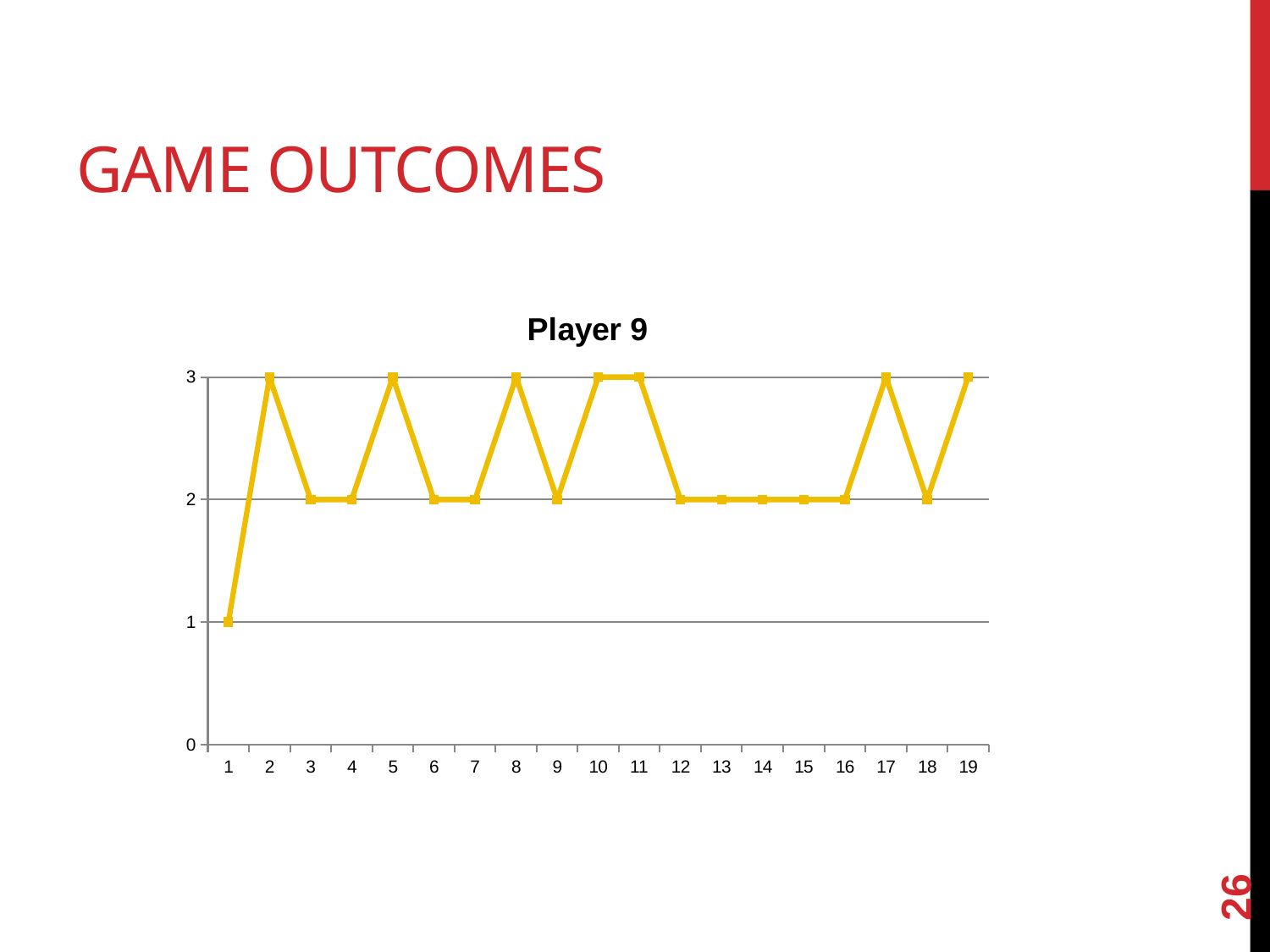
What is the value at game 19? 3 Does the value rise or fall from game 1 to game 2? rise Which game has the lowest value? 1 What is the value at game 14? 2 What is the highest value shown on the y axis? 3 What type of chart is shown on the slide? line chart How many points are plotted on the line? 19 What is the value at game 2? 3 Which is larger, the value at game 11 or the value at game 12? game 11 What is the difference between the value at game 2 and the value at game 1? 2 What is the title of the chart? Player 9 What is the value at game 1? 1